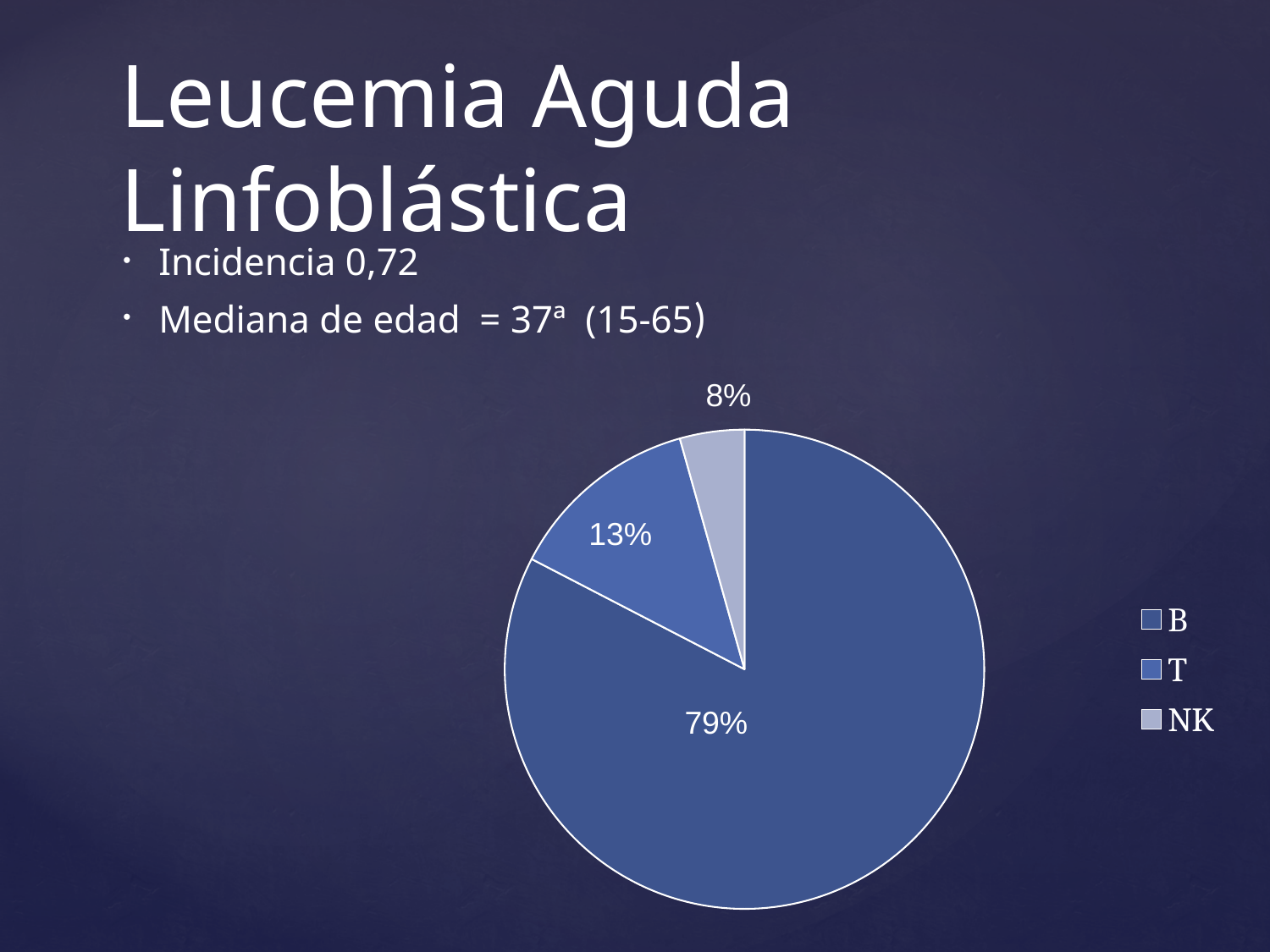
What share of the pie does the B slice represent? 79% What is the difference in percentage points between the T slice and the NK slice? 5 What share of the pie does the NK slice represent? 8% Which slice is larger, T or NK? T What is the difference in percentage points between the B slice and the T slice? 66 Which category has the largest slice of the pie? B Which legend entry is shown in the lightest colour? NK How many slices does the pie chart have? 3 How many entries does the legend list? 3 Which category has the smallest slice of the pie? NK What kind of chart is shown on the slide? pie chart What share of the pie does the T slice represent? 13%